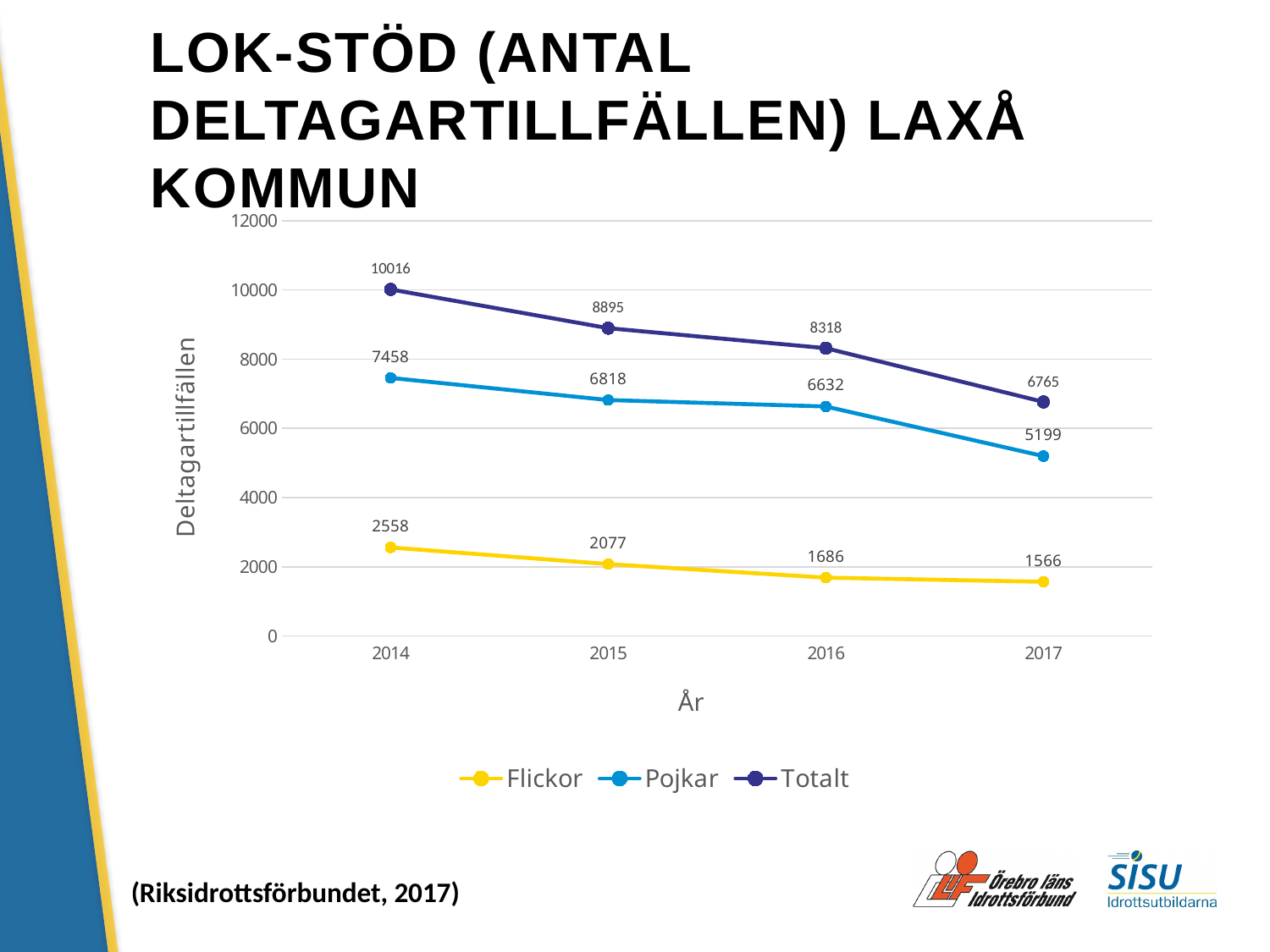
Which is larger, the Flickor value in 2014 or the Flickor value in 2016? 2014 What is the value for Pojkar in 2017? 5199 What kind of chart is shown on the slide? line chart How many series does the legend list? 3 What is the difference between the Pojkar values in 2016 and 2017? 1433 Do the Totalt values rise or fall from 2014 to 2017? fall In which year is the Flickor value lowest? 2017 What is the value for Totalt in 2014? 10016 How many years are shown on the x axis? 4 In which year is the Totalt value highest? 2014 What is the value for Flickor in 2015? 2077 Is the value for Pojkar in 2015 greater or less than 6000? greater